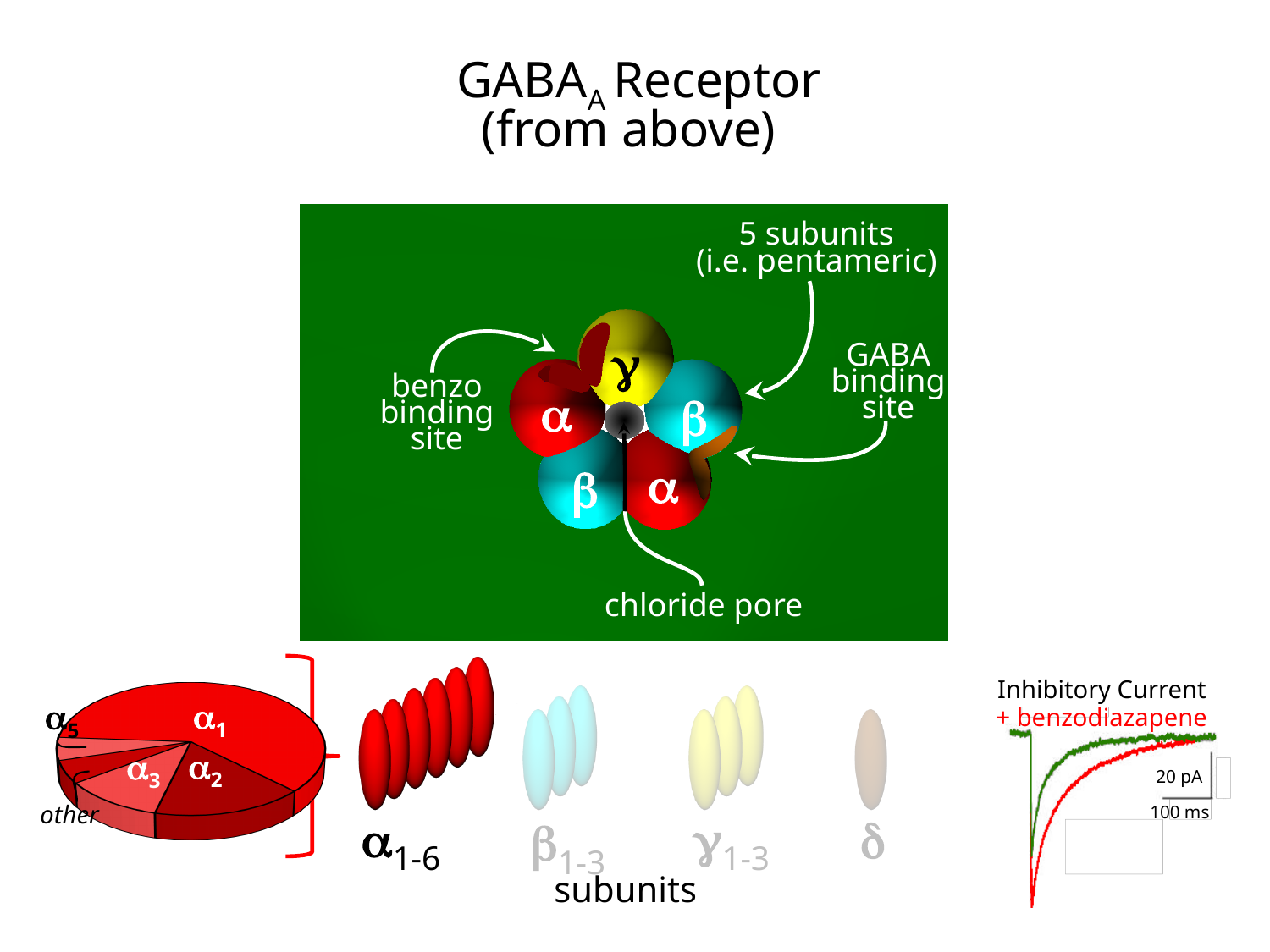
Which slice of the pie chart at the bottom left is the largest? α1 In the Inhibitory Current chart at the bottom right, what does the vertical scale bar represent? 20 pA In the Inhibitory Current chart at the bottom right, does the current return toward baseline faster or slower with benzodiazapene (red trace) than without (green trace)? slower In the pie chart at the bottom left, which slice is larger, α1 or α5? α1 In the pie chart at the bottom left, which slice is larger, α2 or α5? α2 In the Inhibitory Current chart at the bottom right, after the initial downward peak, do the traces rise or fall over time? rise What kind of chart is the Inhibitory Current chart at the bottom right of the slide? line chart How many slices does the pie chart at the bottom left have? 5 In the Inhibitory Current chart at the bottom right, what does the horizontal scale bar represent? 100 ms What kind of chart is shown at the bottom left of the slide? pie chart How many traces are plotted in the Inhibitory Current chart at the bottom right? 2